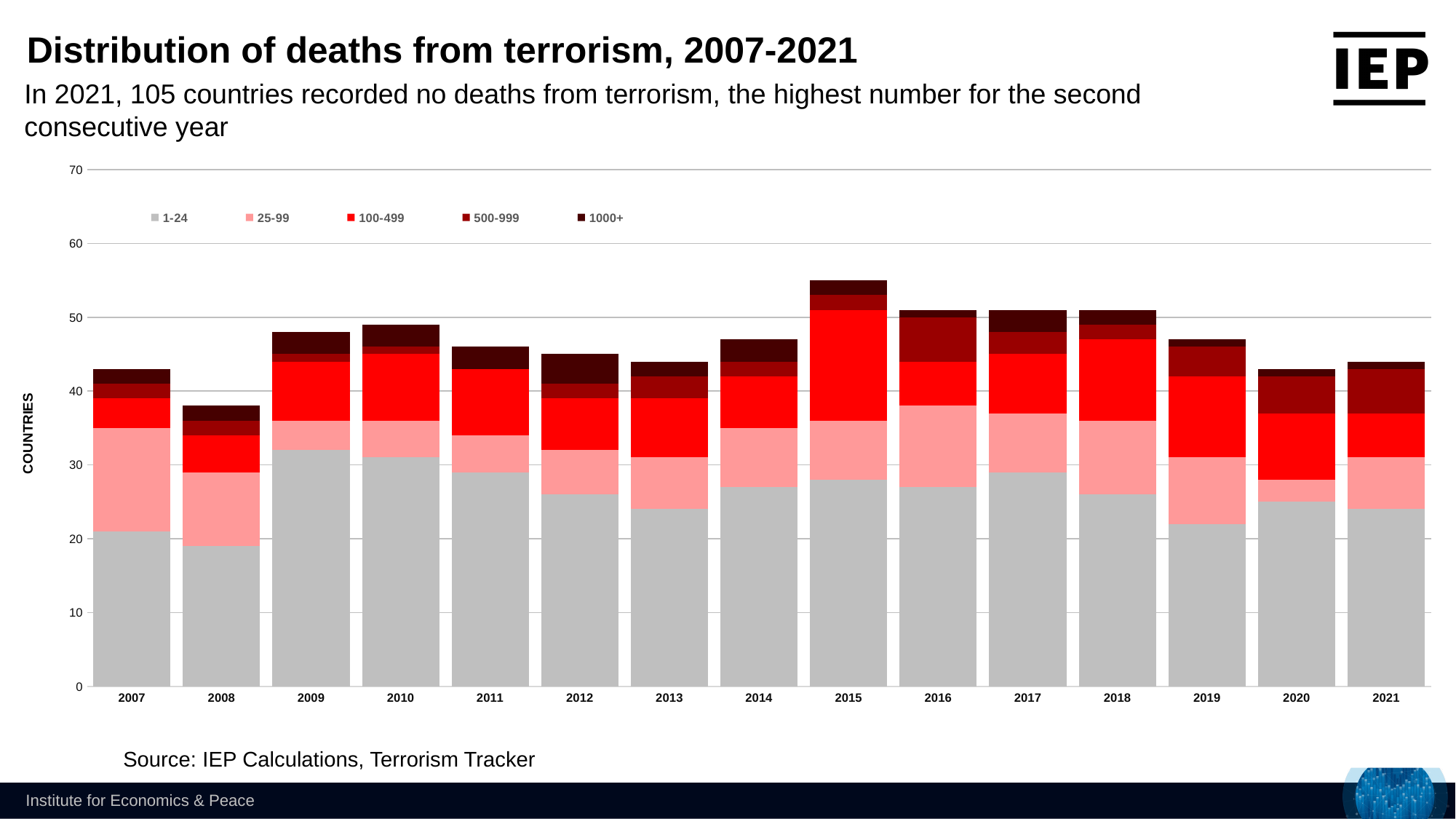
Is the 1-24 segment for 2019 greater or less than 30? less Is the 1-24 segment for 2009 greater or less than 30? greater Which is larger, the total bar for 2015 or the total bar for 2008? 2015 How many years are shown along the x axis of the chart? 15 Which year has the tallest stacked bar (the most countries in total)? 2015 How many series does the chart's legend list? 5 Is the total height of the 2008 bar greater or less than 40? less What is the label on the vertical axis of the chart? COUNTRIES Which year has the shortest stacked bar (the fewest countries in total)? 2008 Do the total bar heights rise or fall from 2008 to 2010? rise What kind of chart is shown on the slide? Stacked bar chart